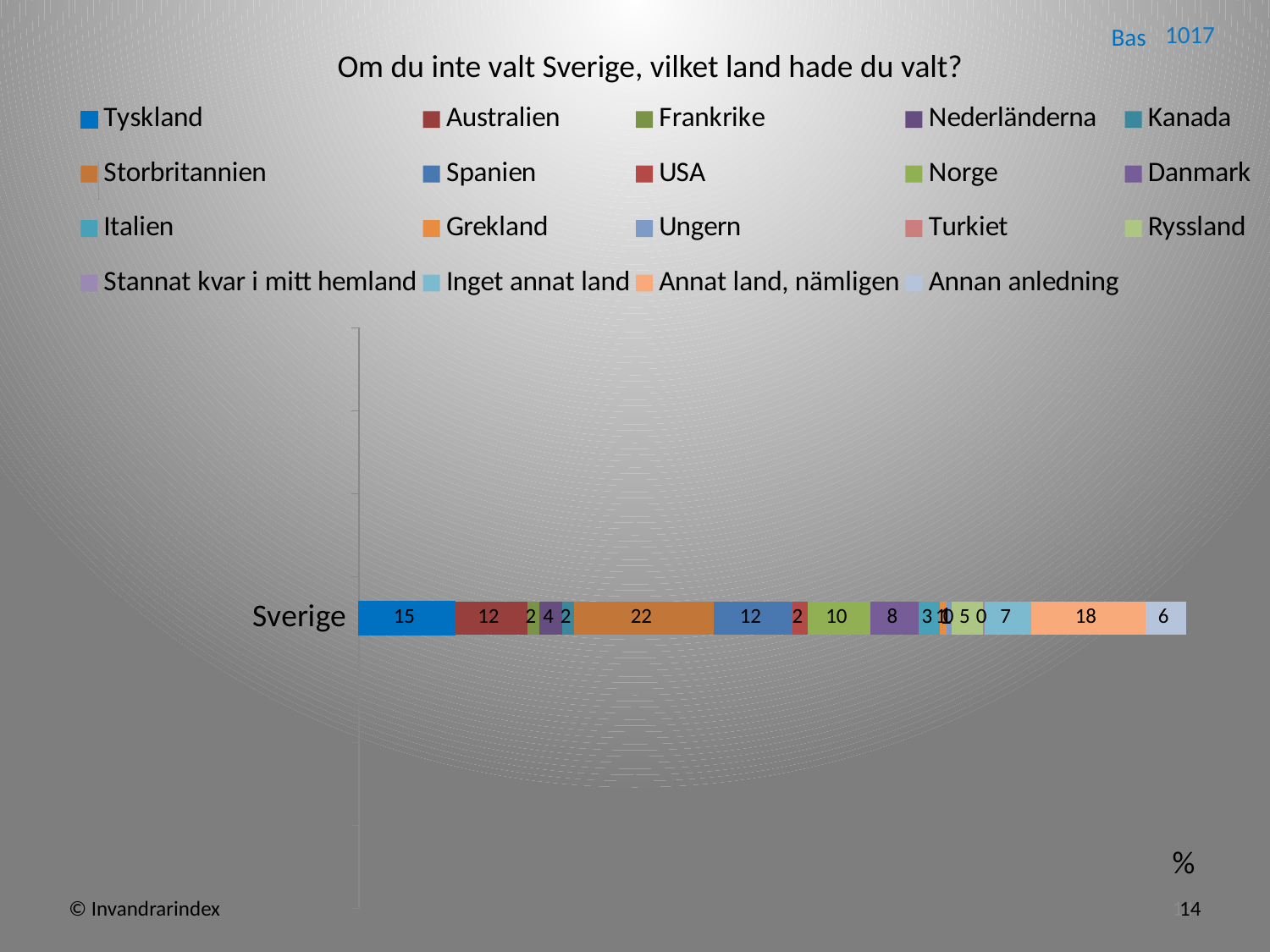
What is the value for Tyskland in the Sverige bar? 15 What is the value for Norge in the Sverige bar? 10 How many series does the legend list? 19 What is the difference between the Storbritannien and Tyskland values? 7 What is the value for Annan anledning in the Sverige bar? 6 Which is larger, the value for Norge or the value for Danmark? Norge What is the value for Storbritannien in the Sverige bar? 22 What kind of chart is shown? Stacked bar chart What is the title of the chart? Om du inte valt Sverige, vilket land hade du valt? How many categories are plotted on the y axis? 1 What is the value for Annat land, nämligen in the Sverige bar? 18 Which series has the largest segment in the Sverige bar? Storbritannien